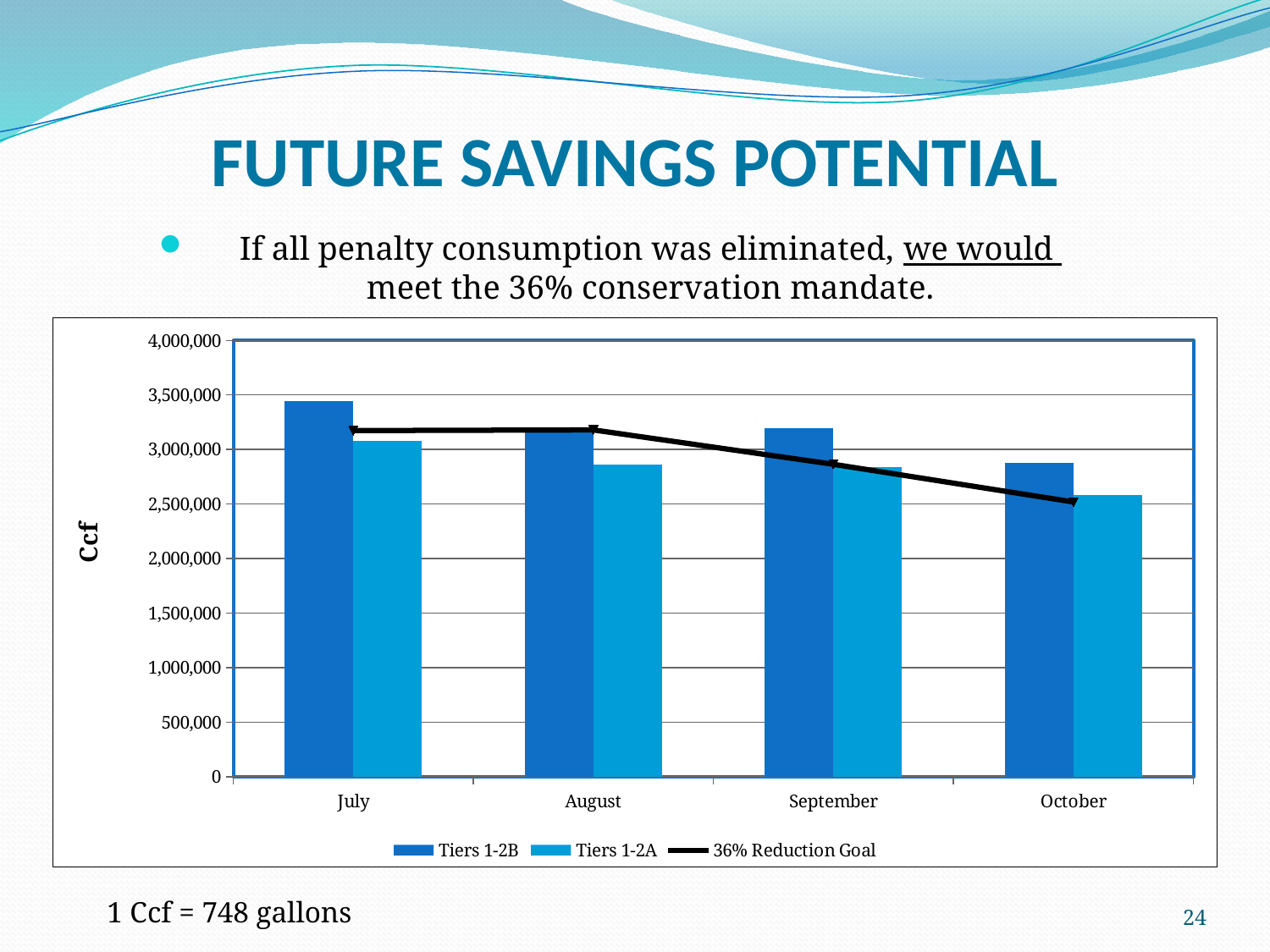
Is the Tiers 1-2B value for July greater or less than 3,000,000? greater What is the label on the vertical axis of the chart? Ccf How many series does the chart legend list? 3 In which month is the Tiers 1-2B bar the highest? July Is the Tiers 1-2A value for August greater or less than 3,000,000? less In which month is the Tiers 1-2A bar the lowest? October In July, which is larger: the Tiers 1-2B bar or the Tiers 1-2A bar? Tiers 1-2B Do the Tiers 1-2A values rise or fall from July to October? Fall What kind of chart is shown on the slide? Combination bar and line chart In which month is the Tiers 1-2A bar the highest? July How many months are shown on the x axis of the chart? 4 In which month is the Tiers 1-2B bar the lowest? October